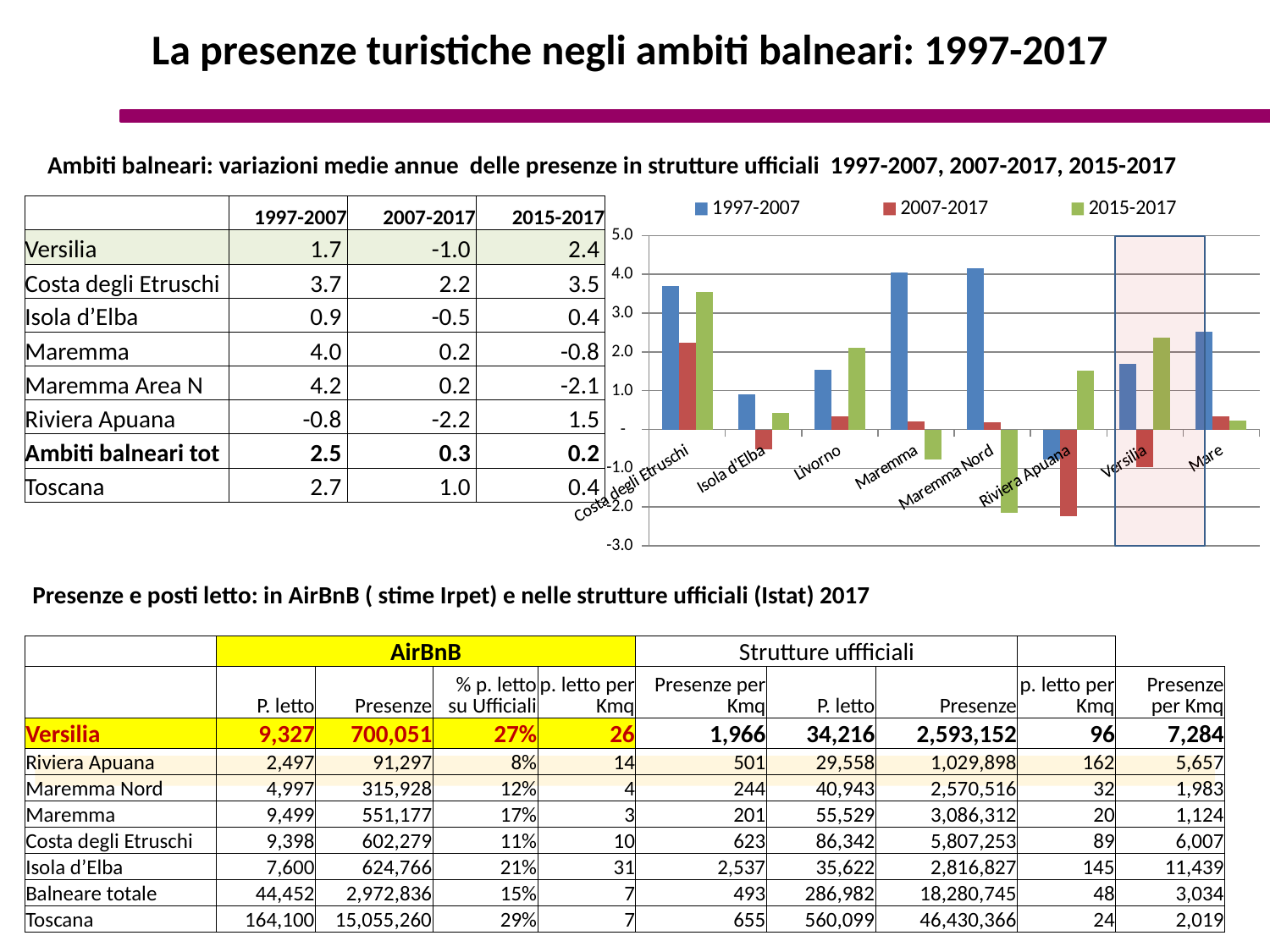
Which category has the highest 2015-2017 bar in the chart? Costa degli Etruschi For Versilia, which is larger in the chart: the 1997-2007 value or the 2015-2017 value? 2015-2017 Is the 2007-2017 value for Riviera Apuana greater or less than -1.0? less How many categories are shown along the x axis of the chart? 8 Is the 2015-2017 value for Versilia greater or less than 2.0? greater How many series does the chart's legend list? 3 Which category has the lowest 2007-2017 bar in the chart? Riviera Apuana Is the 1997-2007 value for Maremma greater or less than 3.0? greater What kind of chart is shown on the slide? bar chart Which is larger in the chart: the 1997-2007 value for Costa degli Etruschi or the 1997-2007 value for Livorno? Costa degli Etruschi Which series in the chart is shown in green? 2015-2017